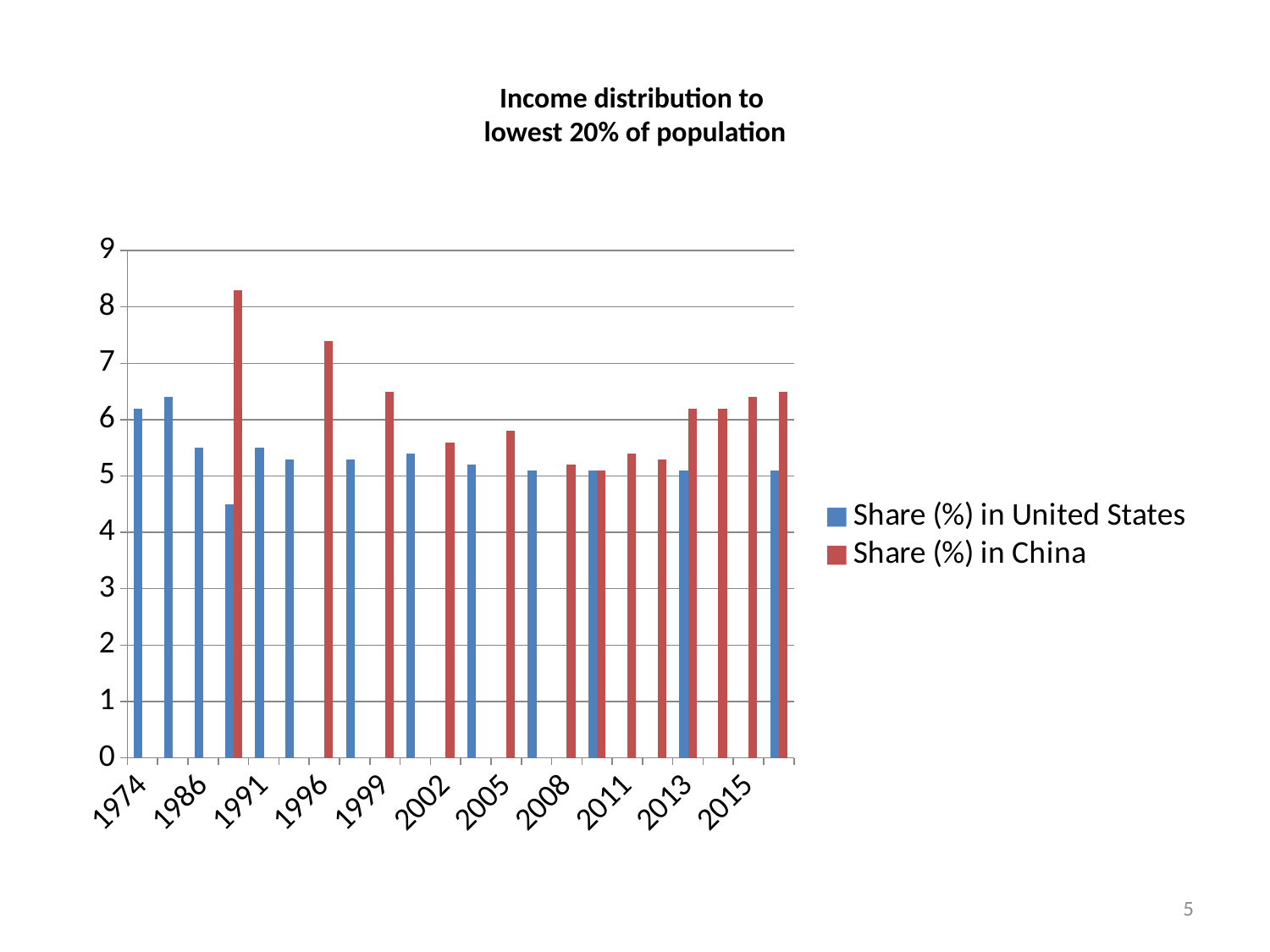
What kind of chart is shown on the slide? bar chart How many series does the legend list? 2 Is the value for Share (%) in United States in 1974 greater or less than 6? greater What is the title of the chart? Income distribution to lowest 20% of population Is the value for Share (%) in China in 2008 greater or less than 6? less Which colour represents Share (%) in China in the chart? red Is the value for Share (%) in China in 1996 greater or less than 7? greater